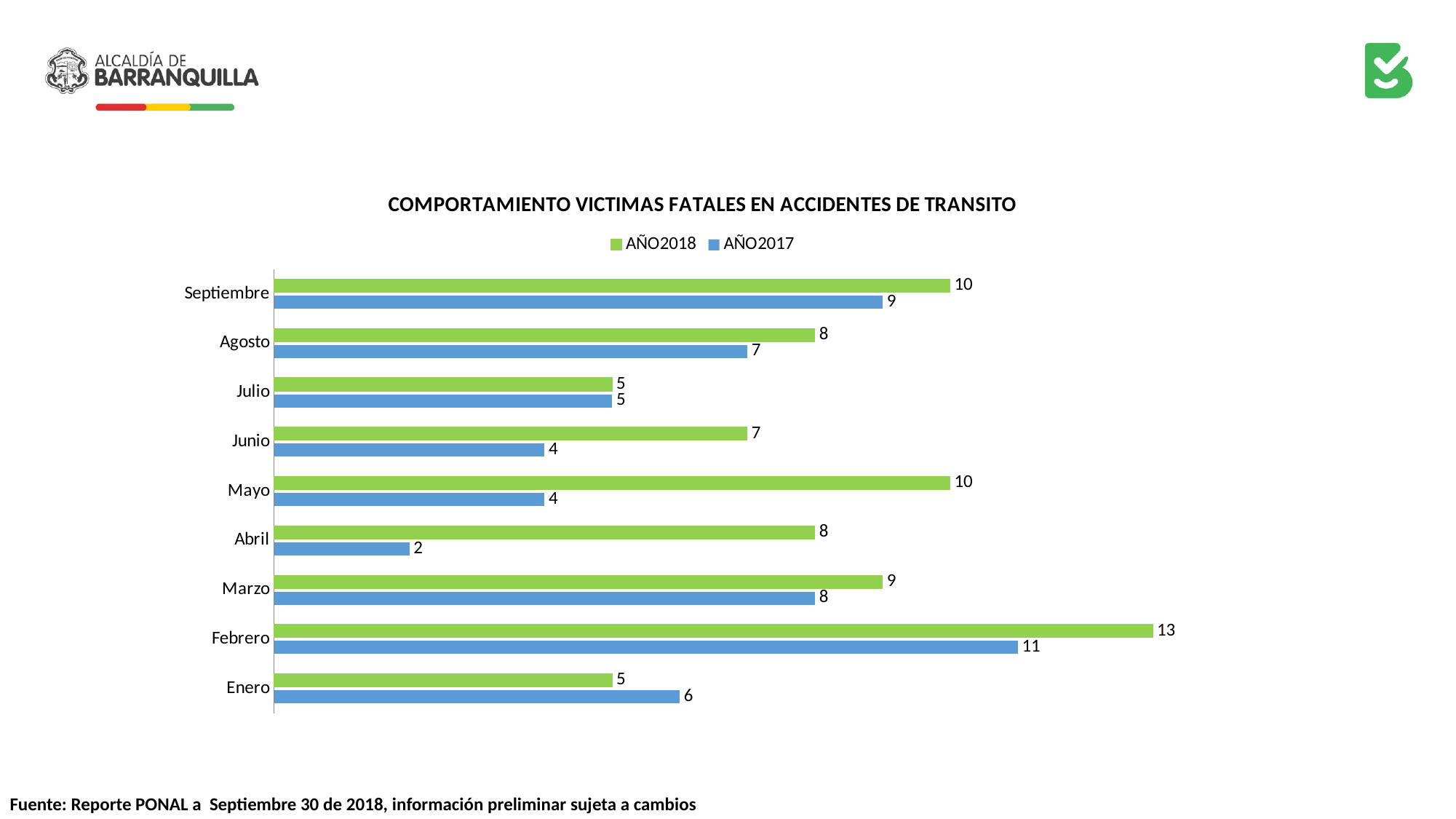
What is the value for AÑO2018 in Febrero? 13 What is the value for AÑO2017 in Abril? 2 Which month has the highest value for AÑO2018? Febrero How many months are shown on the chart? 9 What is the value for AÑO2017 in Septiembre? 9 Which is larger in Enero, AÑO2018 or AÑO2017? AÑO2017 How many series does the legend list? 2 Which colour represents AÑO2017 in the chart? Blue What is the title of the chart? COMPORTAMIENTO VICTIMAS FATALES EN ACCIDENTES DE TRANSITO Which month has the lowest value for AÑO2017? Abril What is the difference between AÑO2018 and AÑO2017 in Mayo? 6 What kind of chart is shown on the slide? Bar chart